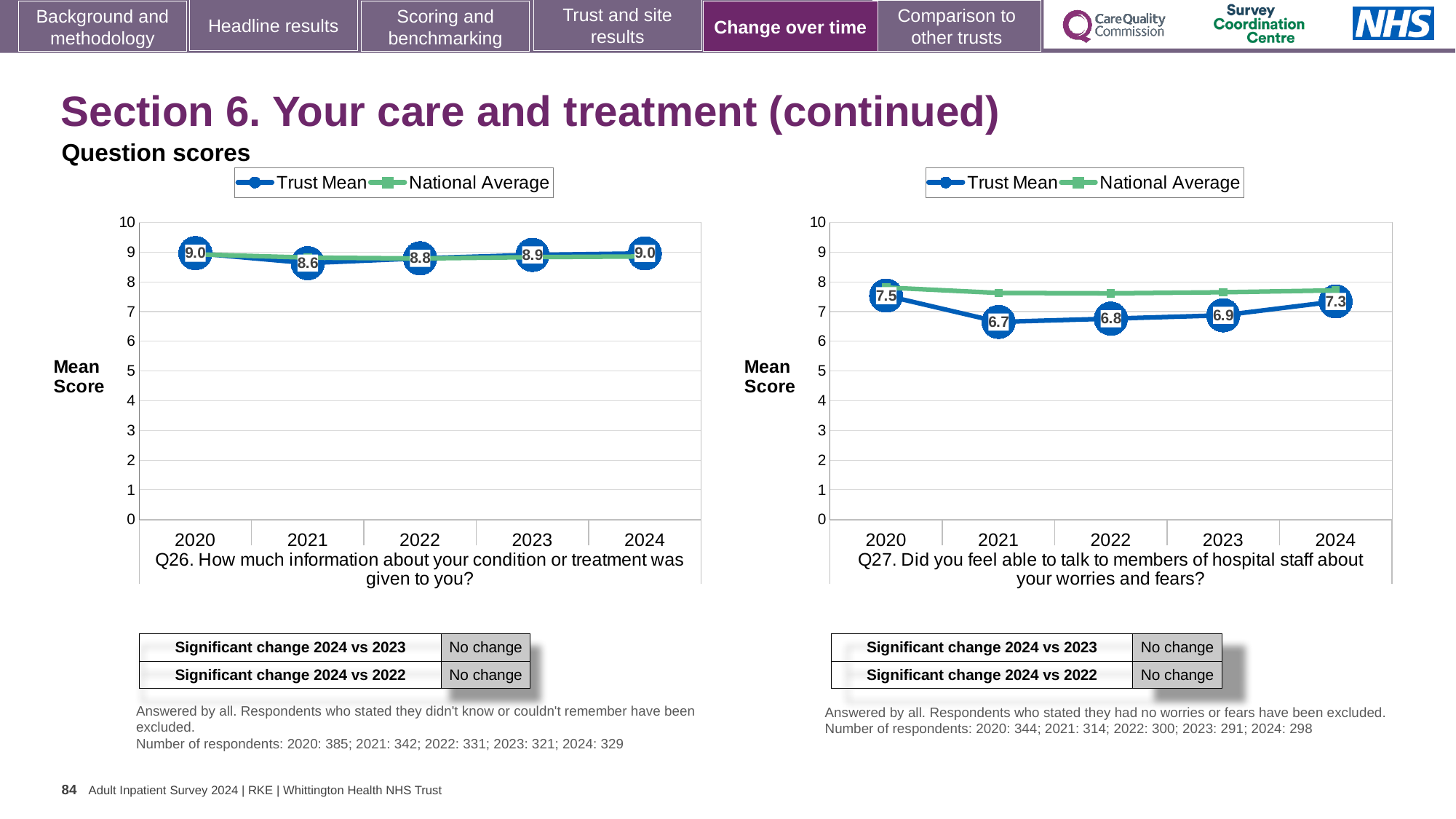
What kind of chart is the Q26 chart (left)? line chart In the Q26 chart (left), what is the Trust Mean score for 2024? 9.0 In the Q26 chart (left), is the Trust Mean score for 2022 larger or smaller than the Trust Mean score for 2023? smaller In the Q27 chart (right), what is the Trust Mean score for 2023? 6.9 In the Q26 chart (left), which year has the lowest Trust Mean score? 2021 How many years are plotted on the x axis of the Q26 chart (left)? 5 In the Q27 chart (right), which year has the lowest Trust Mean score? 2021 In the Q27 chart (right), what is the Trust Mean score for 2020? 7.5 In the Q27 chart (right), is the National Average value for 2021 greater or less than 7? greater How many series does the legend of the Q27 chart (right) list? 2 In the Q26 chart (left), what is the Trust Mean score for 2021? 8.6 In the Q27 chart (right), what is the difference between the Trust Mean scores for 2020 and 2021? 0.8